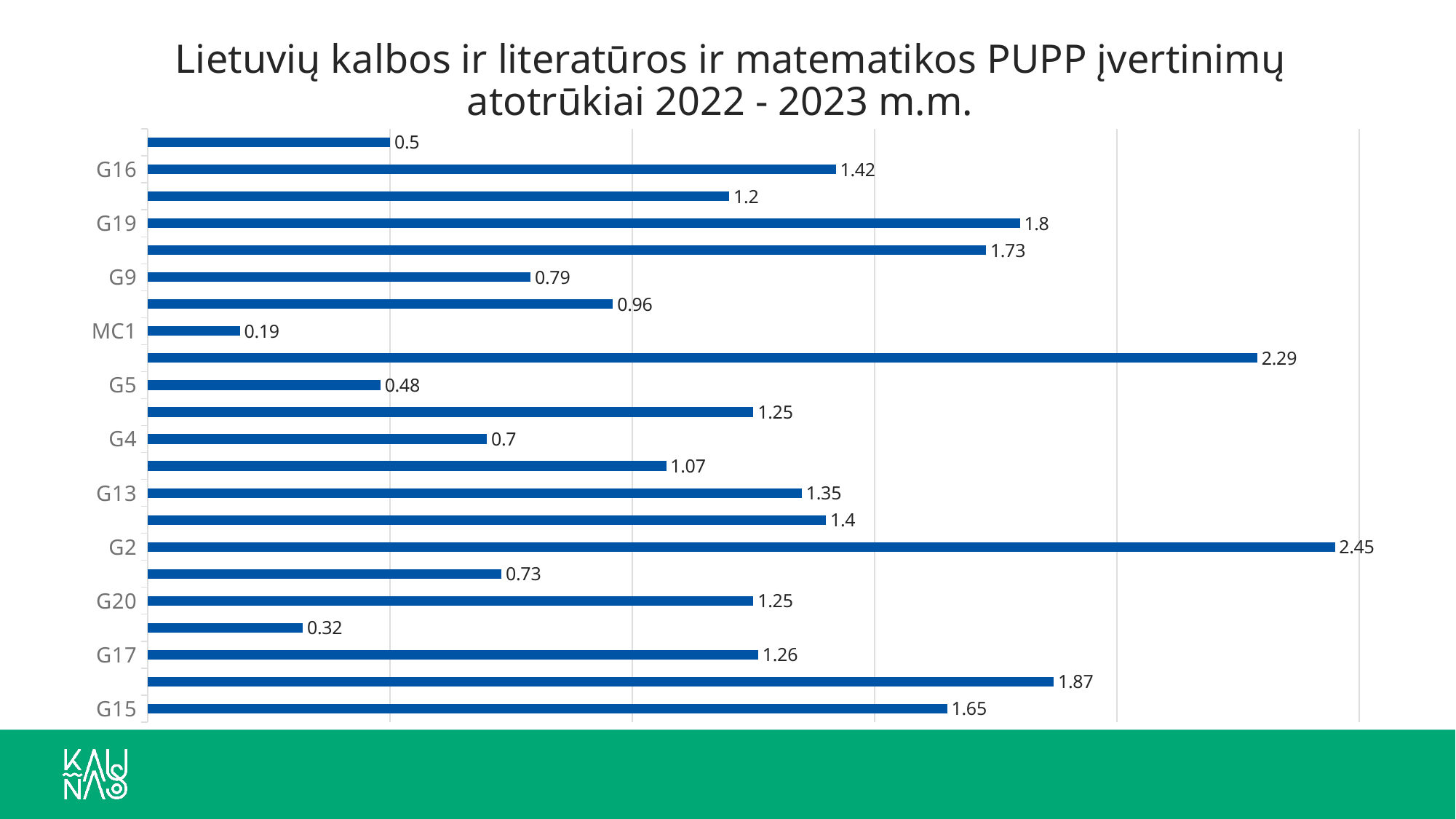
Which category has the highest value? G2 Which category has the lowest value? MC1 What is the value for G2? 2.45 What is the difference between the values for G19 and G9? 1.01 What is the value for G19? 1.8 Which is larger, the value for G16 or the value for G4? G16 What is the value for MC1? 0.19 What is the value for G15? 1.65 What is the value for G13? 1.35 What kind of chart is shown on the slide? bar chart How many bars are plotted in the chart? 22 What is the difference between the values for G2 and G15? 0.8